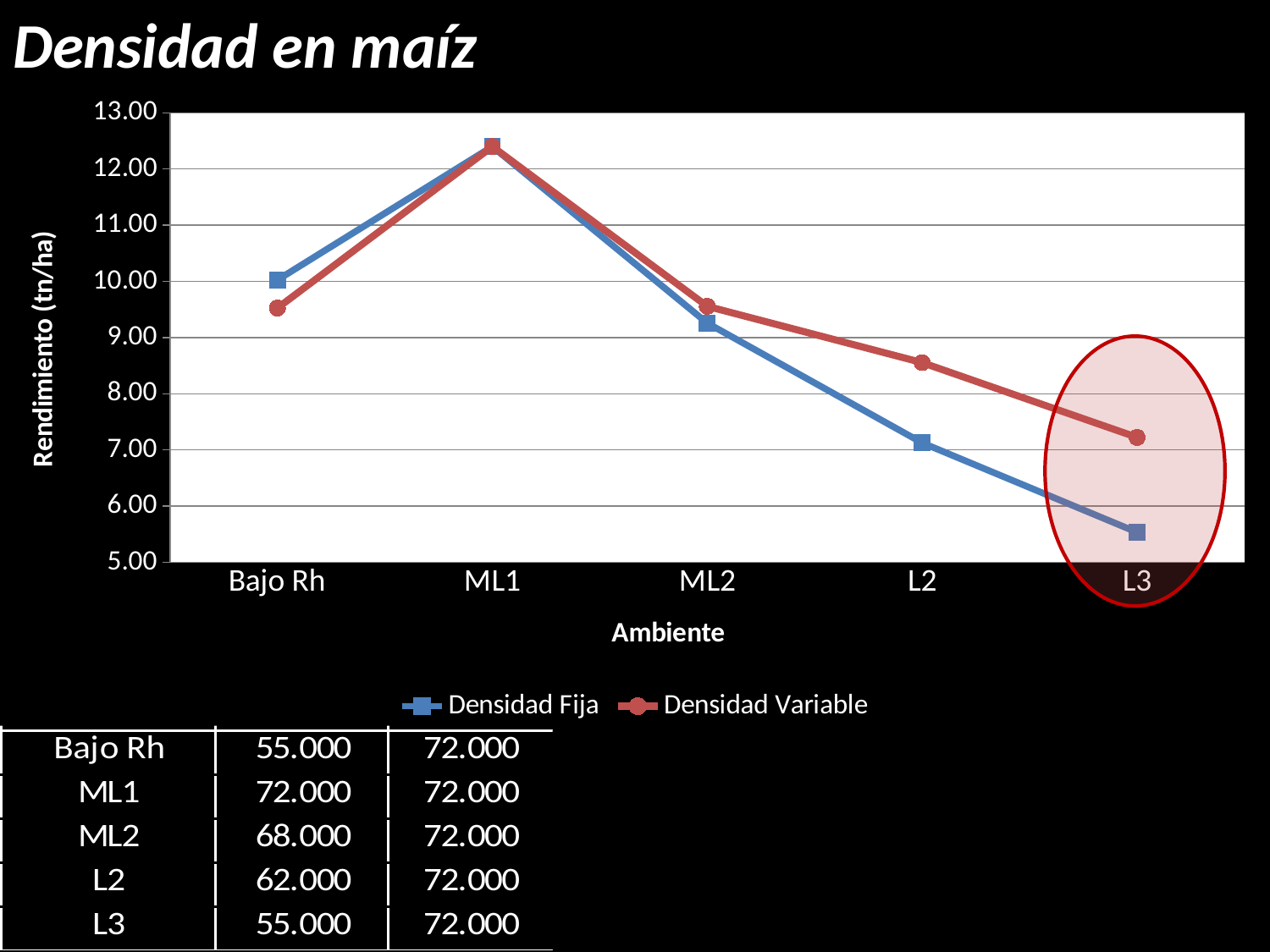
For which category does the Densidad Variable series have its lowest value? L3 At L3, which series has the higher value, Densidad Fija or Densidad Variable? Densidad Variable How many categories are shown on the x axis of the chart? 5 Is the Densidad Fija value for L3 greater or less than 6.00? less What is the label of the chart's vertical axis? Rendimiento (tn/ha) Is the Densidad Fija value for ML1 greater or less than 12.00? greater What kind of chart is shown on the slide? line chart Do the values of the Densidad Fija series rise or fall from ML1 to L3? fall Is the Densidad Variable value for L2 greater or less than 8.00? greater For which category does the Densidad Fija series reach its highest value? ML1 How many series does the chart legend list? 2 At Bajo Rh, which series has the higher value, Densidad Fija or Densidad Variable? Densidad Fija